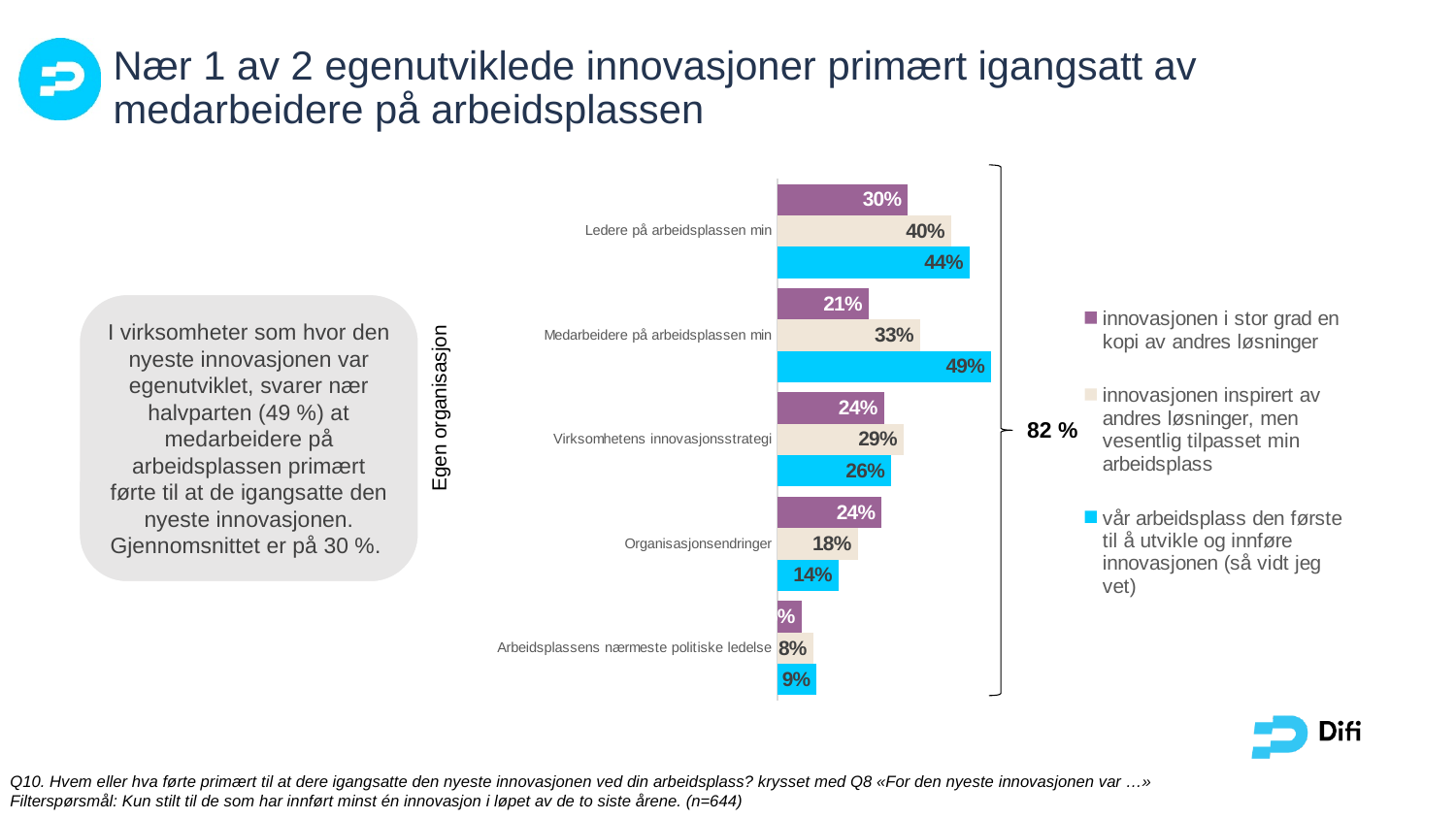
What is the value for 'Ledere på arbeidsplassen min' in the series 'innovasjonen inspirert av andres løsninger, men vesentlig tilpasset min arbeidsplass'? 40% How many series does the legend list? 3 What is the difference between the 'vår arbeidsplass den første...' value and the 'innovasjonen i stor grad en kopi av andres løsninger' value for 'Medarbeidere på arbeidsplassen min'? 28% What kind of chart is shown on the slide? bar chart Which category has the lowest value in the series 'innovasjonen inspirert av andres løsninger, men vesentlig tilpasset min arbeidsplass'? Arbeidsplassens nærmeste politiske ledelse Which category has the highest value in the series 'vår arbeidsplass den første til å utvikle og innføre innovasjonen (så vidt jeg vet)'? Medarbeidere på arbeidsplassen min What is the value for 'Organisasjonsendringer' in the series 'innovasjonen i stor grad en kopi av andres løsninger'? 24% What is the value for 'Medarbeidere på arbeidsplassen min' in the series 'vår arbeidsplass den første til å utvikle og innføre innovasjonen (så vidt jeg vet)'? 49% What is the value for 'Virksomhetens innovasjonsstrategi' in the series 'innovasjonen inspirert av andres løsninger, men vesentlig tilpasset min arbeidsplass'? 29% For 'Organisasjonsendringer', which is larger: the value for 'innovasjonen i stor grad en kopi av andres løsninger' or the value for 'vår arbeidsplass den første til å utvikle og innføre innovasjonen (så vidt jeg vet)'? innovasjonen i stor grad en kopi av andres løsninger How many categories are shown on the chart? 5 What label is shown on the vertical axis of the chart? Egen organisasjon